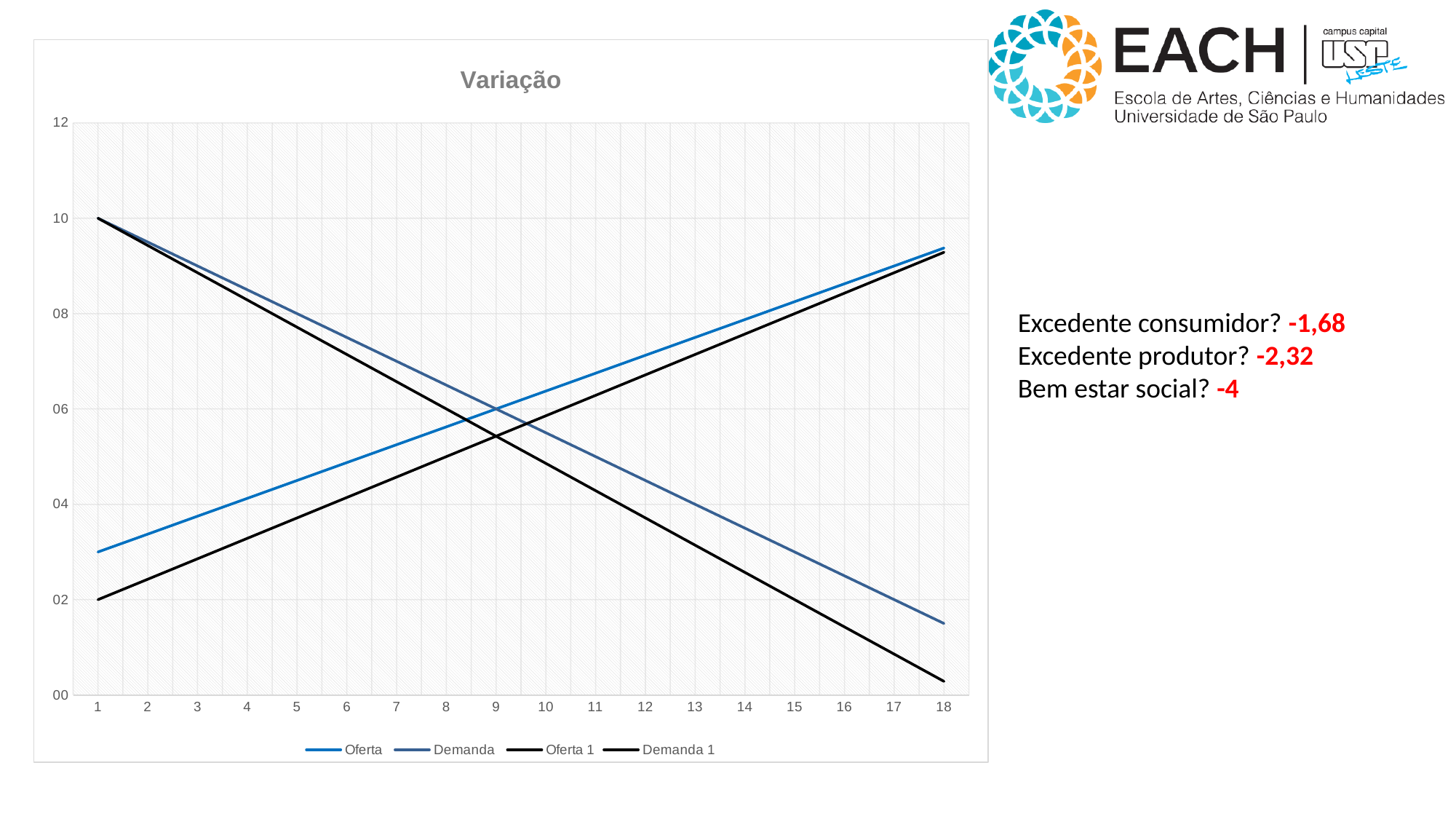
What kind of chart is shown on the slide? line chart At x = 18, which is larger: the Oferta series or the Demanda series? Oferta Is the value of the Oferta series at x = 18 greater or less than 8? greater What is the title of the chart? Variação How many points are on the x axis of the chart? 18 Which series has the lowest value at x = 18? Demanda 1 Is the value of the Demanda series at x = 18 greater or less than 2? less What is the value of the Demanda series at x = 1? 10 Does the Demanda 1 series rise or fall as x increases? fall How many series does the legend list? 4 Does the Oferta series rise or fall as x increases? rise What is the value of the Oferta 1 series at x = 1? 02